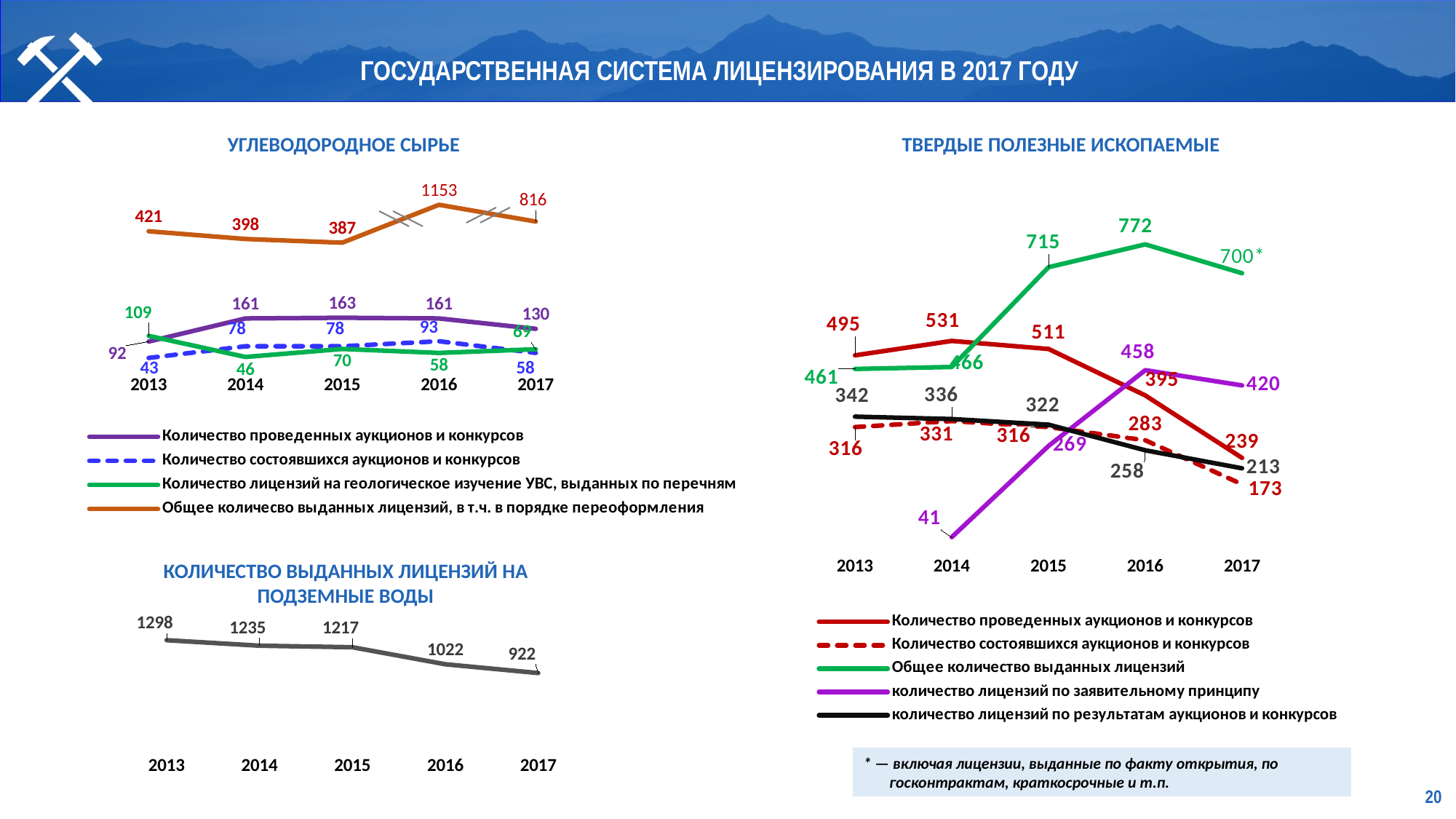
In the 'КОЛИЧЕСТВО ВЫДАННЫХ ЛИЦЕНЗИЙ НА ПОДЗЕМНЫЕ ВОДЫ' chart, what is the value for 2017? 922 In the 'КОЛИЧЕСТВО ВЫДАННЫХ ЛИЦЕНЗИЙ НА ПОДЗЕМНЫЕ ВОДЫ' chart, do the values rise or fall from 2013 to 2017? fall In the 'УГЛЕВОДОРОДНОЕ СЫРЬЕ' chart, what is the value of 'Общее количесво выданных лицензий, в т.ч. в порядке переоформления' in 2016? 1153 How many series does the legend of the 'УГЛЕВОДОРОДНОЕ СЫРЬЕ' chart list? 4 In the 'ТВЕРДЫЕ ПОЛЕЗНЫЕ ИСКОПАЕМЫЕ' chart, which is larger in 2017: 'Количество проведенных аукционов и конкурсов' or 'количество лицензий по результатам аукционов и конкурсов'? Количество проведенных аукционов и конкурсов In the 'УГЛЕВОДОРОДНОЕ СЫРЬЕ' chart, what is the value of 'Количество состоявшихся аукционов и конкурсов' in 2016? 93 In the 'ТВЕРДЫЕ ПОЛЕЗНЫЕ ИСКОПАЕМЫЕ' chart, what is the difference between 'Количество проведенных аукционов и конкурсов' and 'Количество состоявшихся аукционов и конкурсов' in 2013? 179 In the 'КОЛИЧЕСТВО ВЫДАННЫХ ЛИЦЕНЗИЙ НА ПОДЗЕМНЫЕ ВОДЫ' chart, what is the difference between the 2013 and 2017 values? 376 In the 'УГЛЕВОДОРОДНОЕ СЫРЬЕ' chart, in which year is 'Количество проведенных аукционов и конкурсов' lowest? 2013 In the 'ТВЕРДЫЕ ПОЛЕЗНЫЕ ИСКОПАЕМЫЕ' chart, what is the value of 'количество лицензий по заявительному принципу' in 2014? 41 What type of chart is the 'ТВЕРДЫЕ ПОЛЕЗНЫЕ ИСКОПАЕМЫЕ' chart? line chart In the 'ТВЕРДЫЕ ПОЛЕЗНЫЕ ИСКОПАЕМЫЕ' chart, in which year is 'Общее количество выданных лицензий' highest? 2016